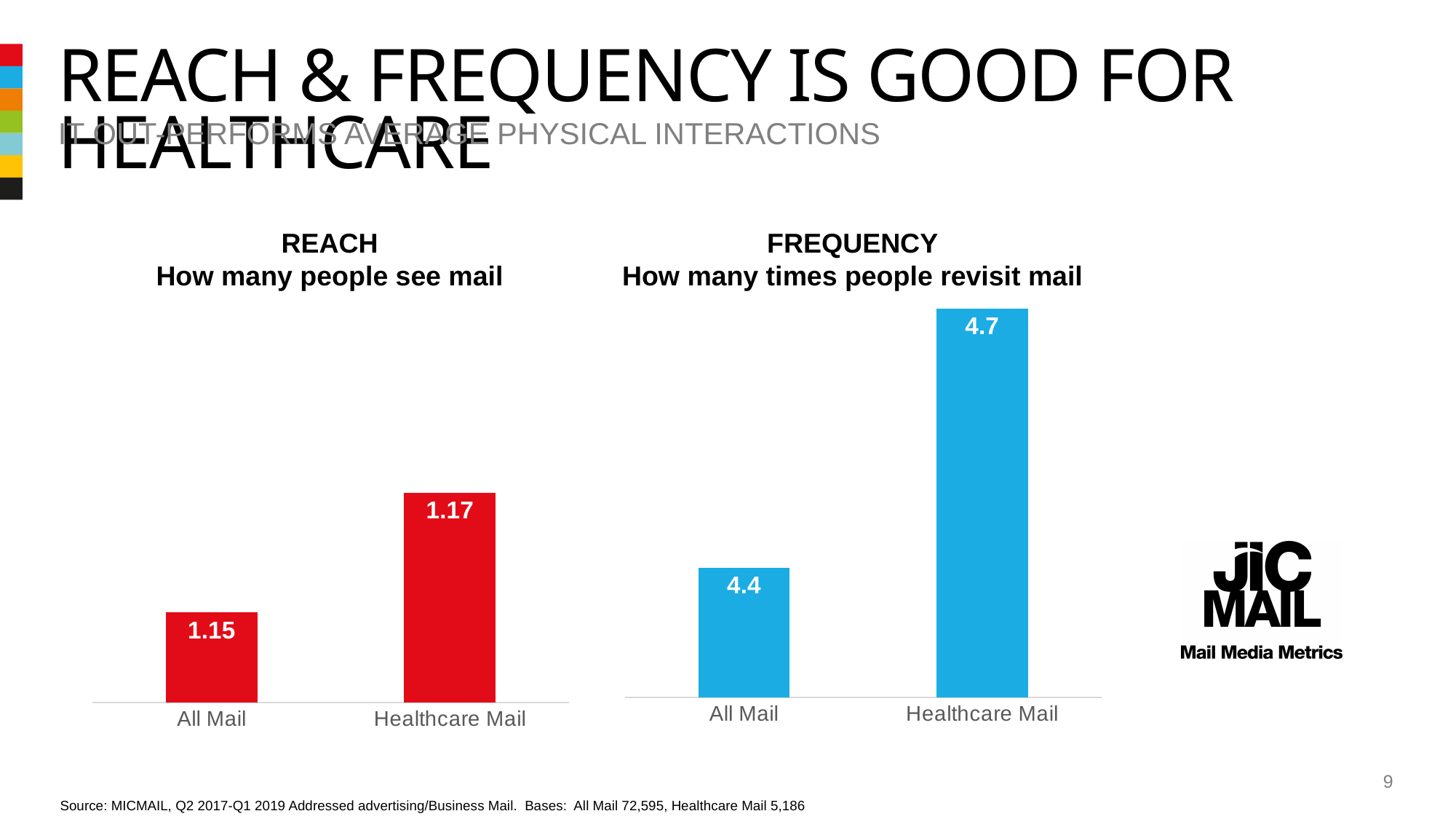
In the REACH chart, which category has the lowest value? All Mail How many categories are shown in the FREQUENCY chart? 2 In the REACH chart, what is the value for Healthcare Mail? 1.17 What kind of chart is the REACH chart? Bar chart In the FREQUENCY chart, what is the value for All Mail? 4.4 In the REACH chart, which is larger, All Mail or Healthcare Mail? Healthcare Mail In the REACH chart, what is the value for All Mail? 1.15 In the REACH chart, what is the difference between Healthcare Mail and All Mail? 0.02 What colour are the bars in the FREQUENCY chart? Blue In the FREQUENCY chart, what is the value for Healthcare Mail? 4.7 In the FREQUENCY chart, which category has the highest value? Healthcare Mail In the FREQUENCY chart, what is the difference between Healthcare Mail and All Mail? 0.3